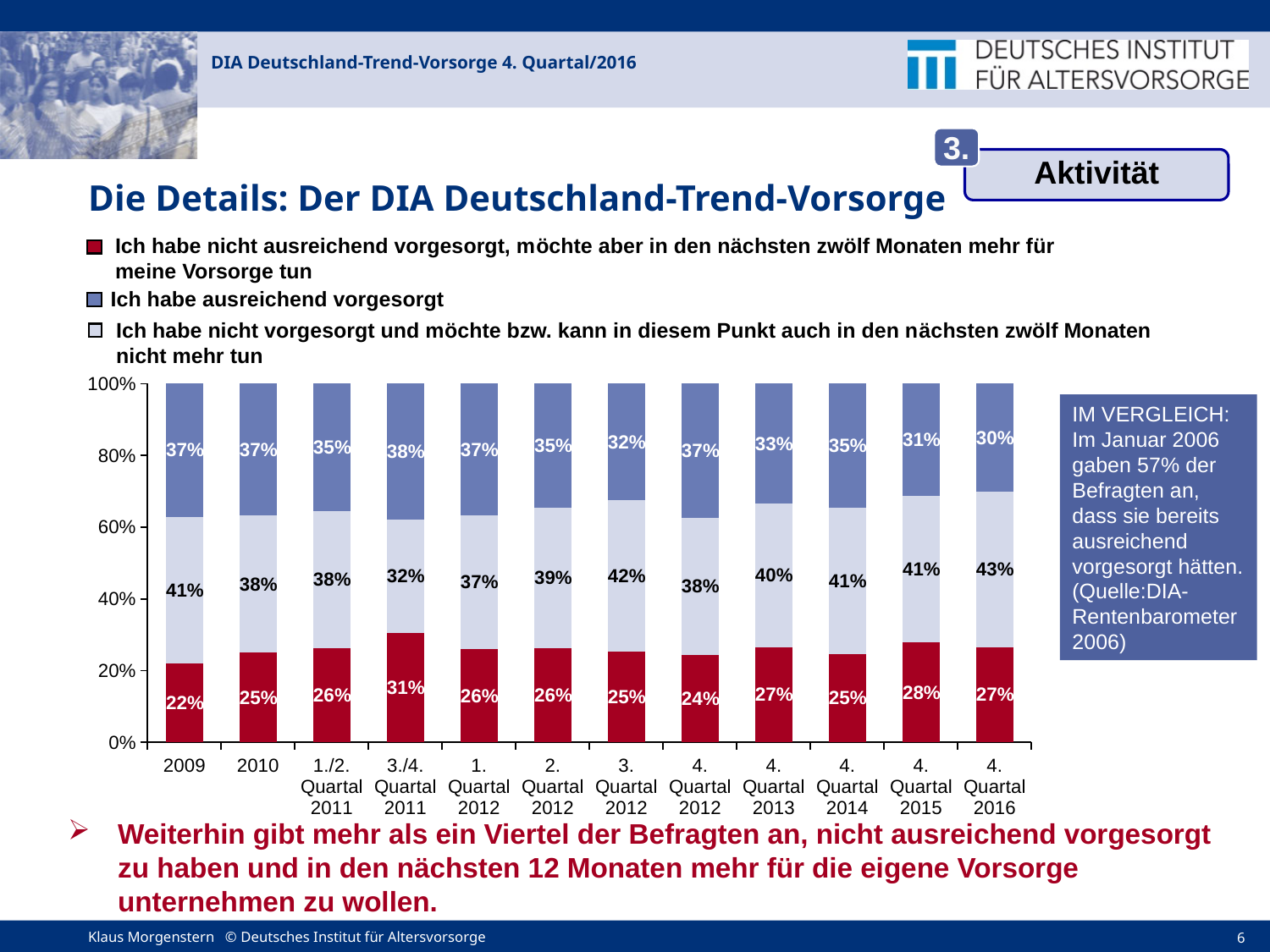
How many series does the legend list? 3 What is the value of the bottom (red) segment for 3./4. Quartal 2011? 31% What is the difference between the middle segment values for 4. Quartal 2016 and 3./4. Quartal 2011? 11 percentage points Which has the larger bottom (red) segment value, 2009 or 2010? 2010 What is the value of the top segment for 3. Quartal 2012? 32% What is the total of the stacked bar for 2009? 100% In which period is the bottom (red) segment the highest? 3./4. Quartal 2011 What kind of chart is shown on the slide? Stacked bar chart How many categories (time periods) are shown on the x axis of the chart? 12 In which period is the top segment the lowest? 4. Quartal 2016